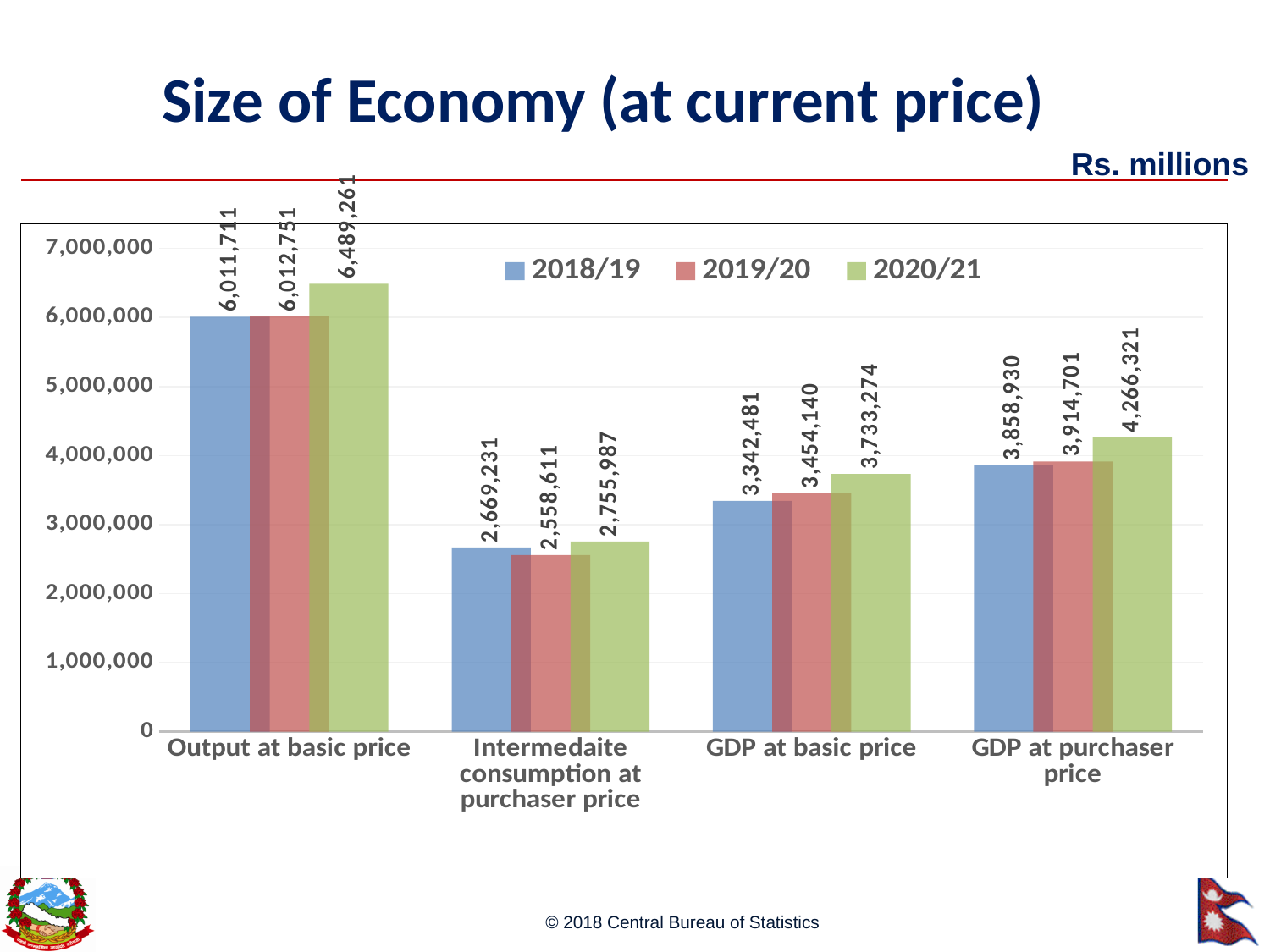
What is the value for GDP at basic price in 2019/20? 3,454,140 Which is larger for Intermedaite consumption at purchaser price: the 2018/19 value or the 2019/20 value? 2018/19 What is the value for Intermedaite consumption at purchaser price in 2019/20? 2,558,611 How many series does the legend list? 3 What is the difference between the 2020/21 and 2018/19 values for GDP at basic price? 390,793 What kind of chart is shown on the slide? Bar chart What is the value for Output at basic price in 2020/21? 6,489,261 Which category has the lowest value in 2018/19? Intermedaite consumption at purchaser price Which category has the highest value in 2020/21? Output at basic price How many categories are shown on the x axis? 4 What is the difference between the 2020/21 and 2019/20 values for GDP at purchaser price? 351,620 What is the value for GDP at purchaser price in 2018/19? 3,858,930